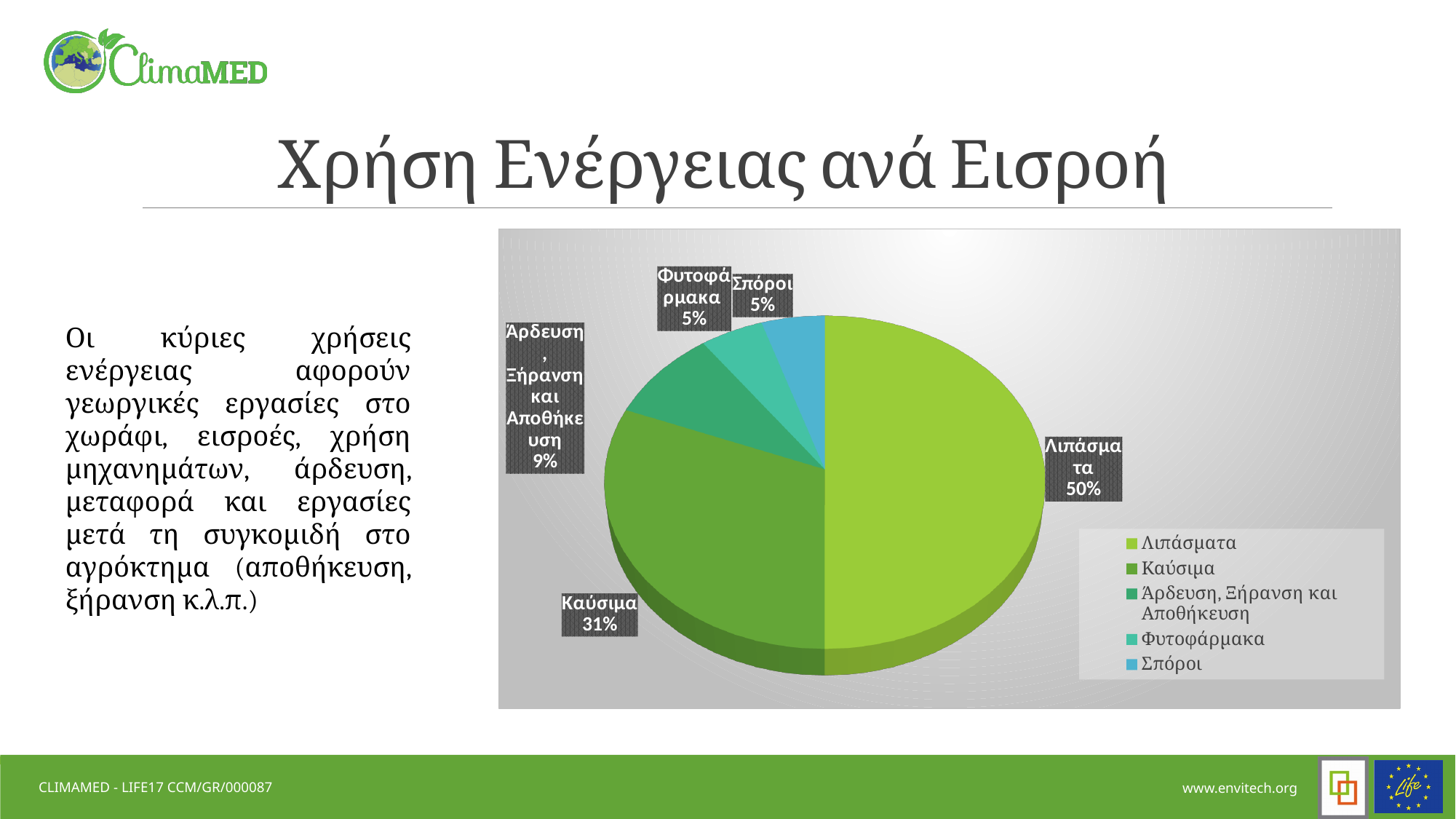
What type of chart is shown on the slide? Pie chart What share of the pie does Καύσιμα represent? 31% What share of the pie does Φυτοφάρμακα represent? 5% How many entries does the legend list? 5 What is the title of the slide containing the pie chart? Χρήση Ενέργειας ανά Εισροή How many slices does the pie chart have? 5 Which category has the largest slice of the pie? Λιπάσματα What is the difference in percentage points between the Λιπάσματα slice and the Καύσιμα slice? 19% What share of the pie does Σπόροι represent? 5% Which is larger, the slice for Καύσιμα or the slice for Άρδευση, Ξήρανση και Αποθήκευση? Καύσιμα